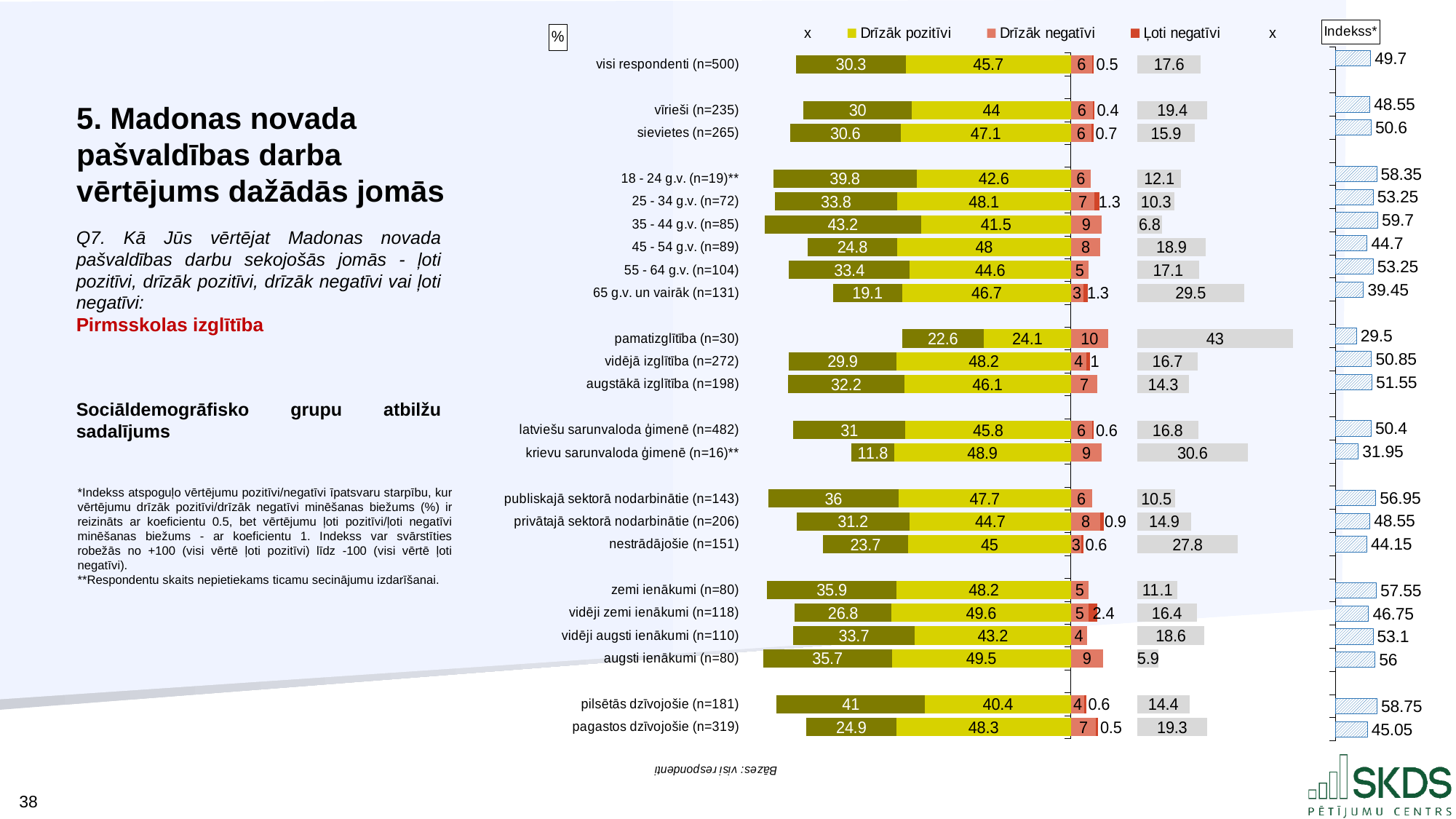
What is the Drīzāk negatīvi value for 35 - 44 g.v. (n=85)? 9 What is the difference between the Indekss* values for sievietes (n=265) and vīrieši (n=235)? 2.05 What is the difference between the Drīzāk pozitīvi values for sievietes (n=265) and vīrieši (n=235)? 3.1 How many respondent groups are shown in the chart? 23 Which respondent group has the lowest Indekss* value? pamatizglītība (n=30) What is the value of the leftmost (dark olive) segment for pilsētās dzīvojošie (n=181)? 41 What is the Drīzāk pozitīvi value for visi respondenti (n=500)? 45.7 What is the value of the grey segment for pamatizglītība (n=30)? 43 What is the Indekss* value for visi respondenti (n=500)? 49.7 Which has the larger Drīzāk pozitīvi value: pilsētās dzīvojošie (n=181) or pagastos dzīvojošie (n=319)? pagastos dzīvojošie (n=319) Which respondent group has the highest Indekss* value? 35 - 44 g.v. (n=85) What kind of chart is used to show the respondent groups' ratings? Stacked bar chart